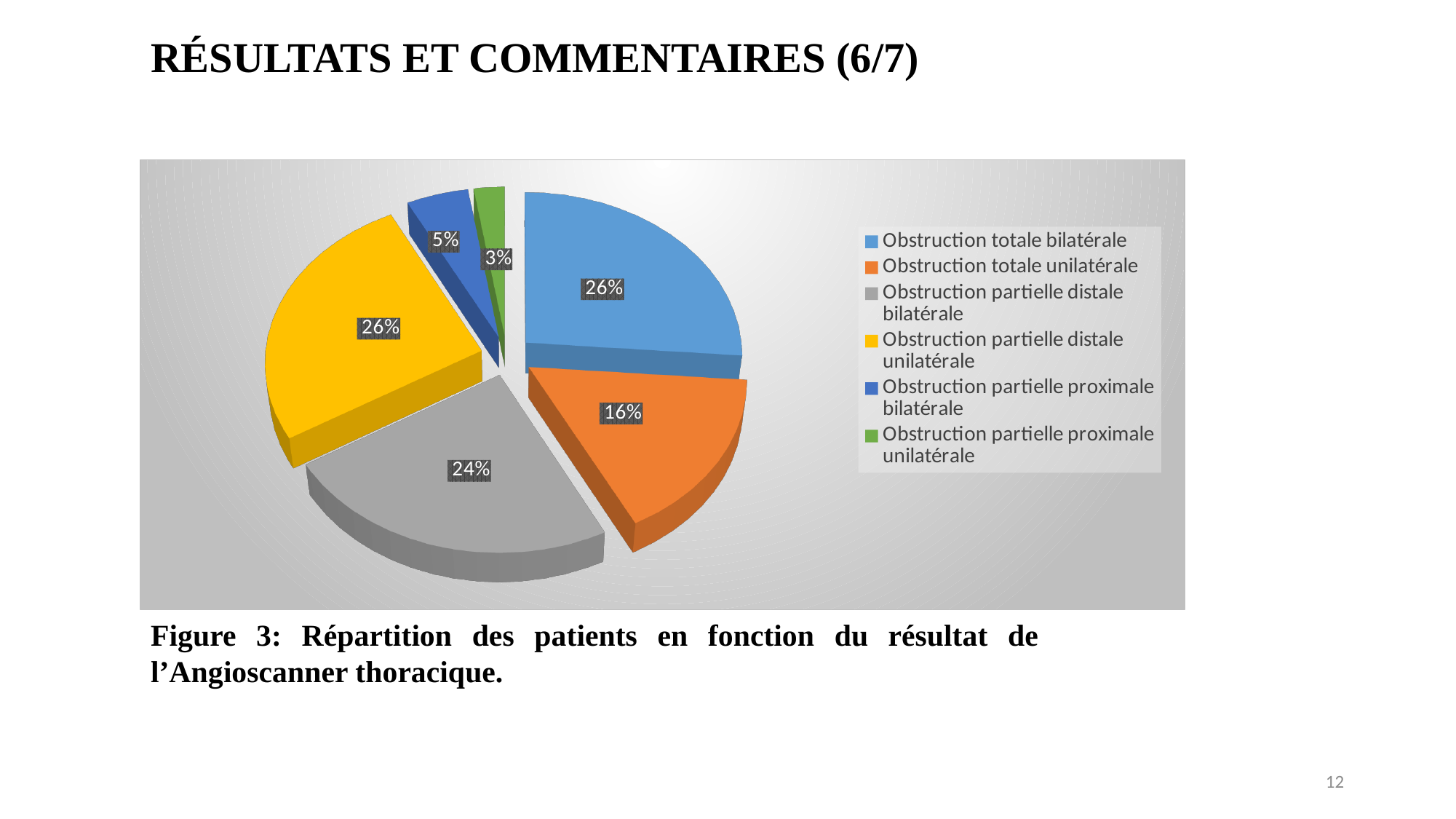
What is the difference between the shares for Obstruction partielle distale bilatérale and Obstruction totale unilatérale? 8% Which category has the smallest slice of the pie? Obstruction partielle proximale unilatérale What colour is the slice for Obstruction partielle distale unilatérale? yellow What share of patients had Obstruction partielle proximale bilatérale? 5% What share of patients had Obstruction totale bilatérale? 26% What share of patients had Obstruction totale unilatérale? 16% What is the figure caption below the chart? Figure 3: Répartition des patients en fonction du résultat de l'Angioscanner thoracique. What kind of chart is shown on the slide? pie chart How many categories does the pie chart show? 6 Which is larger: the share for Obstruction totale unilatérale or for Obstruction partielle distale bilatérale? Obstruction partielle distale bilatérale